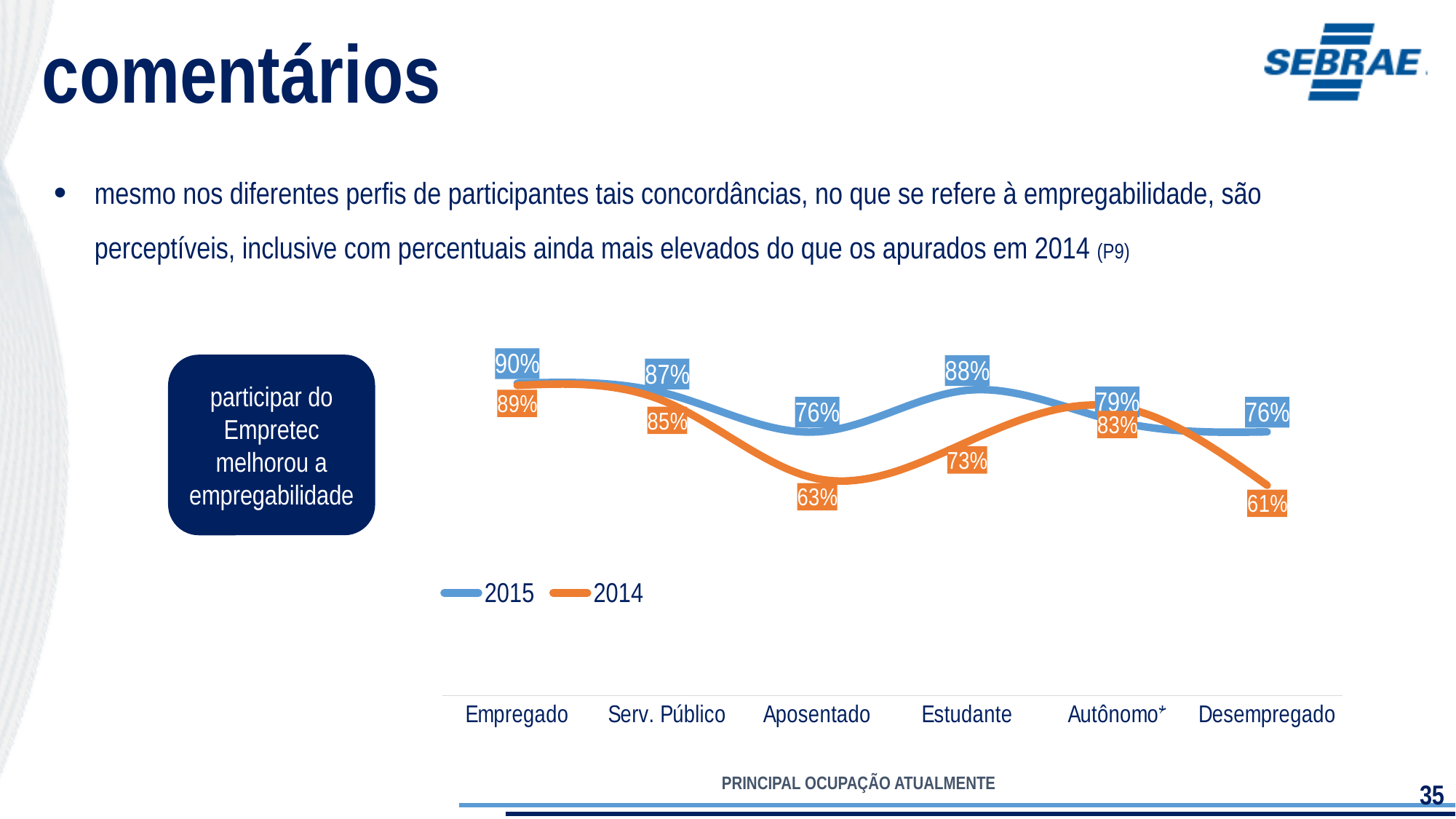
How many series does the legend list? 2 How many categories are shown on the x axis? 6 What is the 2015 value for Desempregado? 76% Which category has the highest 2015 value? Empregado What is the 2014 value for Autônomo? 83% What is the difference between the 2015 and 2014 values for Estudante? 15% What kind of chart is shown on the slide? Line chart What is the x-axis title of the chart? PRINCIPAL OCUPAÇÃO ATUALMENTE Which category has the lowest 2014 value? Desempregado What is the 2015 value for Empregado? 90% What is the 2014 value for Aposentado? 63% For Autônomo, which series has the larger value, 2015 or 2014? 2014